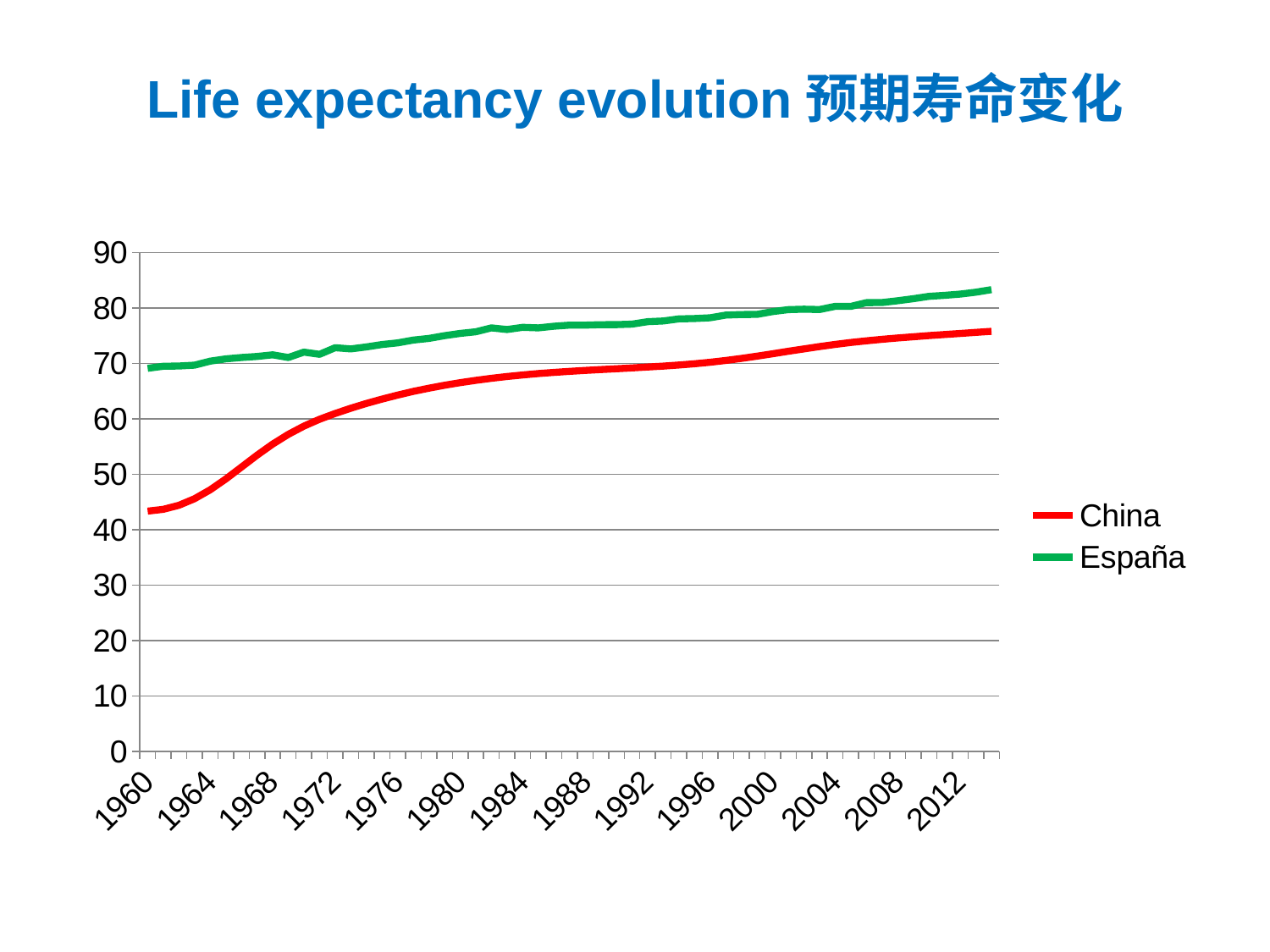
Which two series are shown in the legend? China and España Is the value for China in 2012 greater or less than 70? greater Is the value for España in 2012 greater or less than 80? greater What kind of chart is shown on the slide? line chart Is the value for China in 1960 greater or less than 50? less Does the life expectancy for España rise or fall from 1960 to 2012? rise Which series has the higher value in 1960, China or España? España How many series does the legend list? 2 Does the life expectancy for China rise or fall from 1960 to 2012? rise Which series has the higher value in 2012, China or España? España What colour is the line for China? red